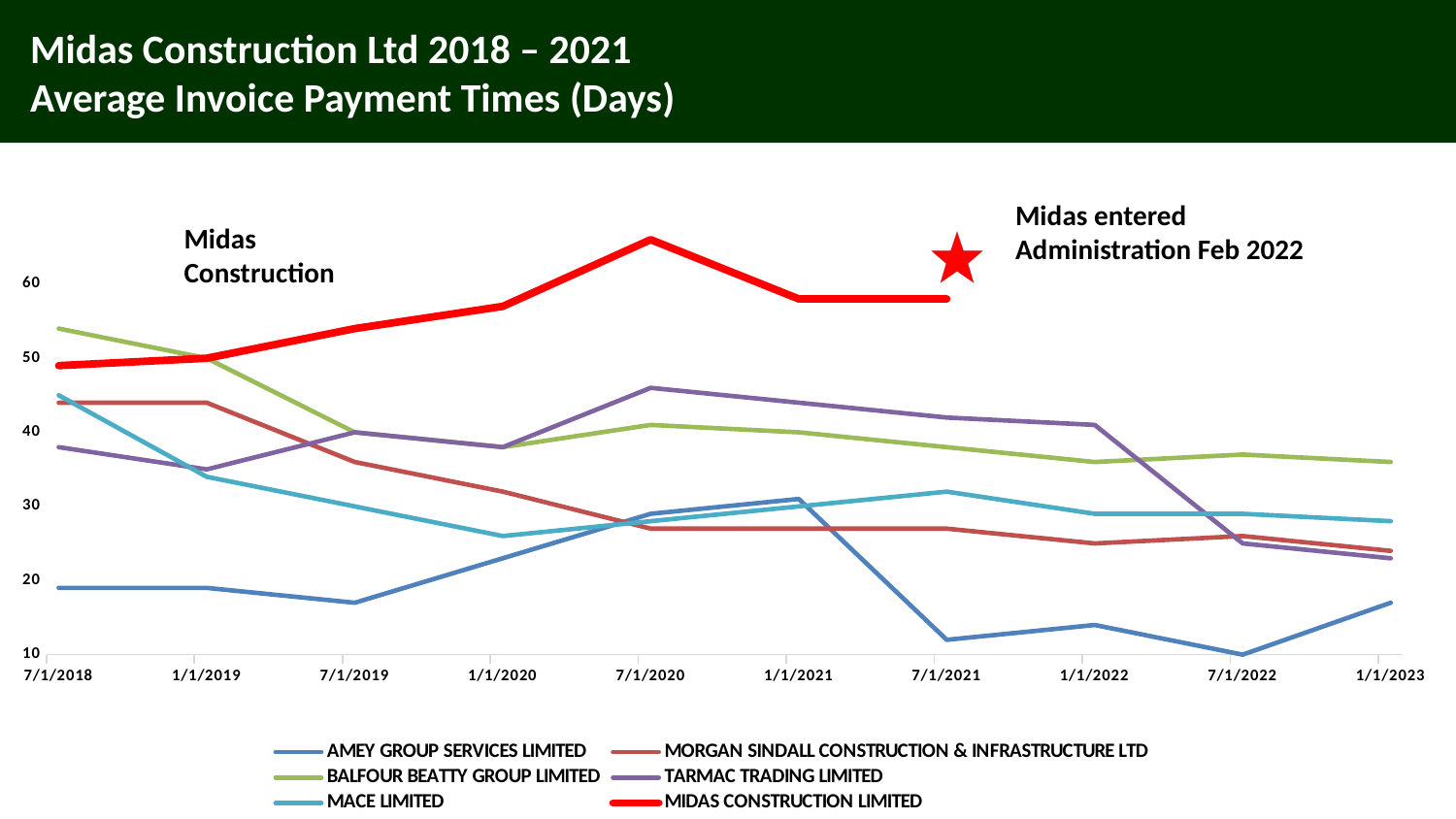
Does the MIDAS CONSTRUCTION LIMITED line rise or fall from 7/1/2018 to 7/1/2020? rise What kind of chart is shown on the slide? line chart Which series has the lowest value at 7/1/2018? AMEY GROUP SERVICES LIMITED How many series does the legend list? 6 Which series has the highest value at 7/1/2020? MIDAS CONSTRUCTION LIMITED Is the value for BALFOUR BEATTY GROUP LIMITED at 7/1/2018 greater or less than 50? greater Which series has the highest value at 1/1/2023? BALFOUR BEATTY GROUP LIMITED Is the value for AMEY GROUP SERVICES LIMITED at 7/1/2021 greater or less than 20? less At 1/1/2020, which is larger: the value for MIDAS CONSTRUCTION LIMITED or the value for BALFOUR BEATTY GROUP LIMITED? MIDAS CONSTRUCTION LIMITED Is the value for MIDAS CONSTRUCTION LIMITED at 7/1/2020 greater or less than 60? greater How many dates are labelled along the x axis? 10